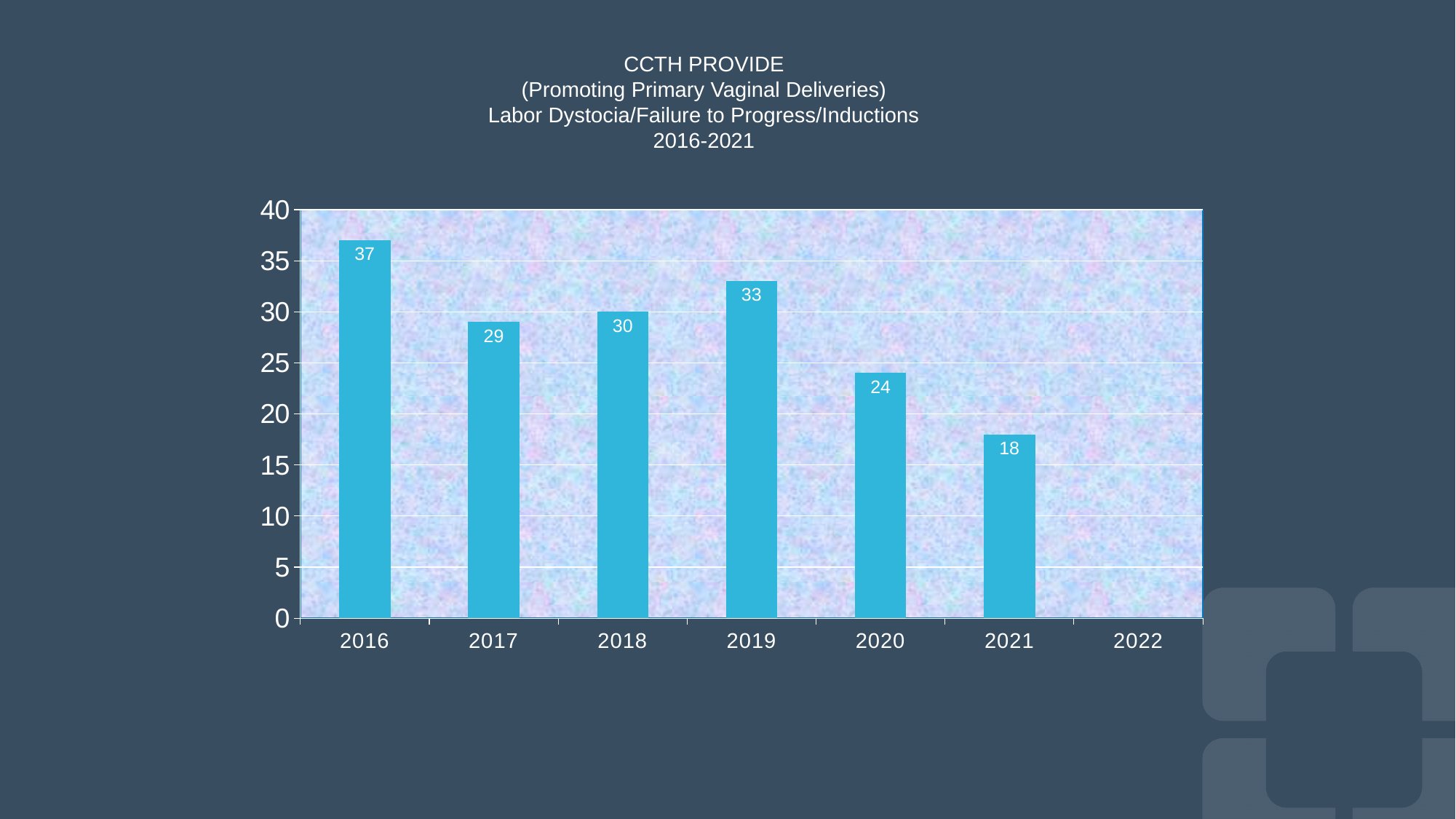
How many years have a bar plotted? 6 Do the values generally rise or fall from 2016 to 2021? fall What kind of chart is shown? bar chart What is the value for 2021? 18 Is the value for 2020 greater or less than 25? less Which year has the highest value? 2016 What is the value for 2016? 37 What is the difference between the values for 2016 and 2021? 19 What is the value for 2019? 33 What is the difference between the values for 2019 and 2020? 9 Which year with a bar has the lowest value? 2021 Which is larger, the value for 2017 or the value for 2018? 2018